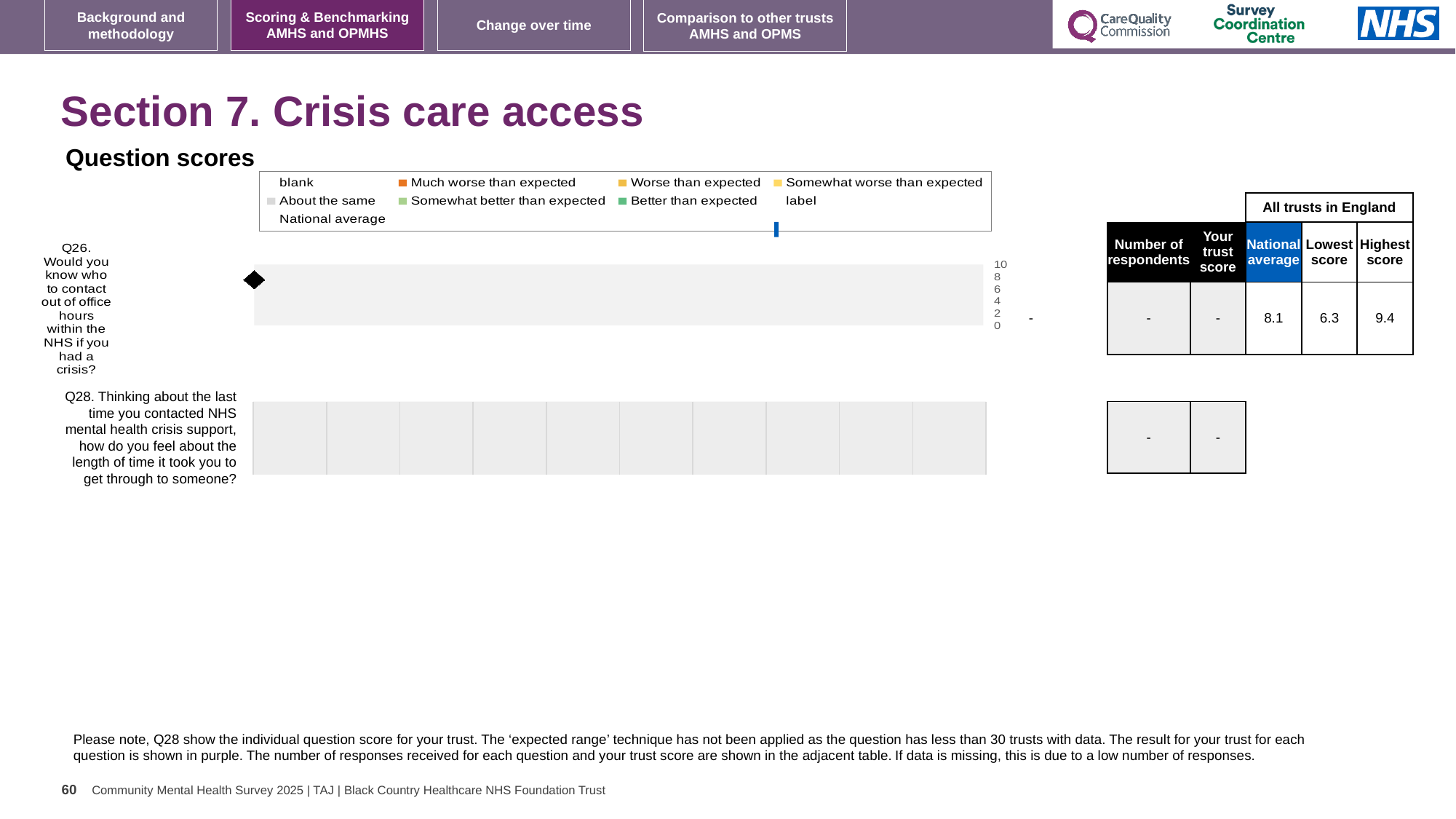
Which legend entry on the question scores chart is shown in orange? Much worse than expected In the table next to the question scores chart, what is the lowest score for Q26? 6.3 What is the highest value shown on the question scores chart's axis? 10 In the table next to the question scores chart, what is shown as the trust score for Q28? - In the table next to the question scores chart, is the national average for Q26 greater or less than the lowest score? greater In the table next to the question scores chart, what is the national average for Q26? 8.1 How many questions are listed as categories on the question scores chart? 2 What kind of chart is used for the question scores in Section 7. Crisis care access? bar chart In the table next to the question scores chart, what is the difference between the highest score and the lowest score for Q26? 3.1 In the table next to the question scores chart, what is the highest score for Q26? 9.4